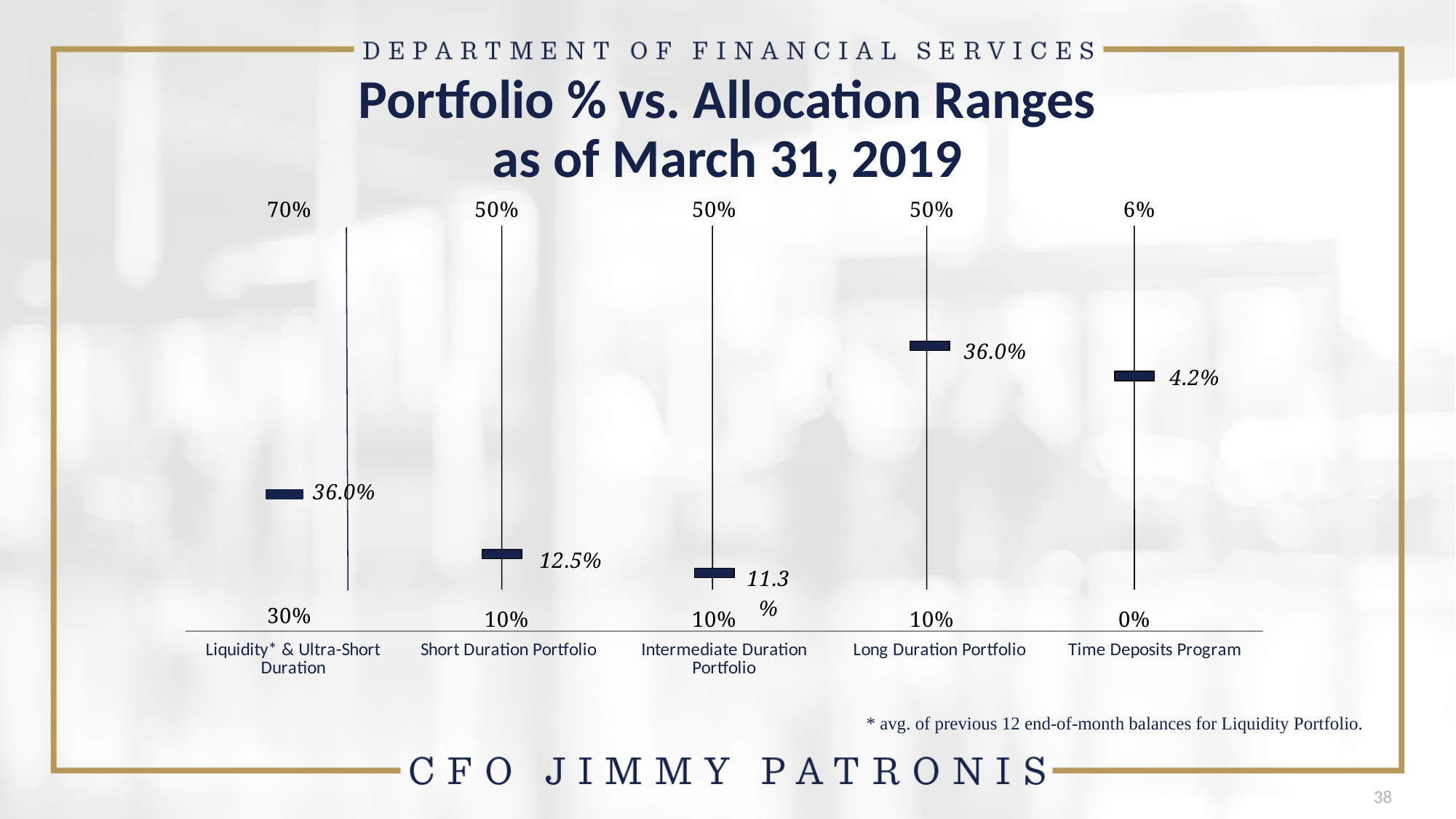
What is the portfolio percentage shown for the Long Duration Portfolio? 36.0% Which category has the lowest portfolio percentage? Time Deposits Program What is the lower end of the allocation range for the Time Deposits Program? 0% What is the title of the chart? Portfolio % vs. Allocation Ranges as of March 31, 2019 Which is larger, the portfolio percentage for the Short Duration Portfolio or for the Time Deposits Program? Short Duration Portfolio What is the portfolio percentage shown for the Time Deposits Program? 4.2% What is the difference between the portfolio percentages of the Short Duration Portfolio and the Intermediate Duration Portfolio? 1.2% What is the portfolio percentage shown for the Short Duration Portfolio? 12.5% What is the portfolio percentage shown for the Intermediate Duration Portfolio? 11.3% What is the difference between the upper and lower ends of the allocation range for the Long Duration Portfolio? 40% How many portfolio categories are shown on the chart? 5 What is the upper end of the allocation range for Liquidity & Ultra-Short Duration? 70%